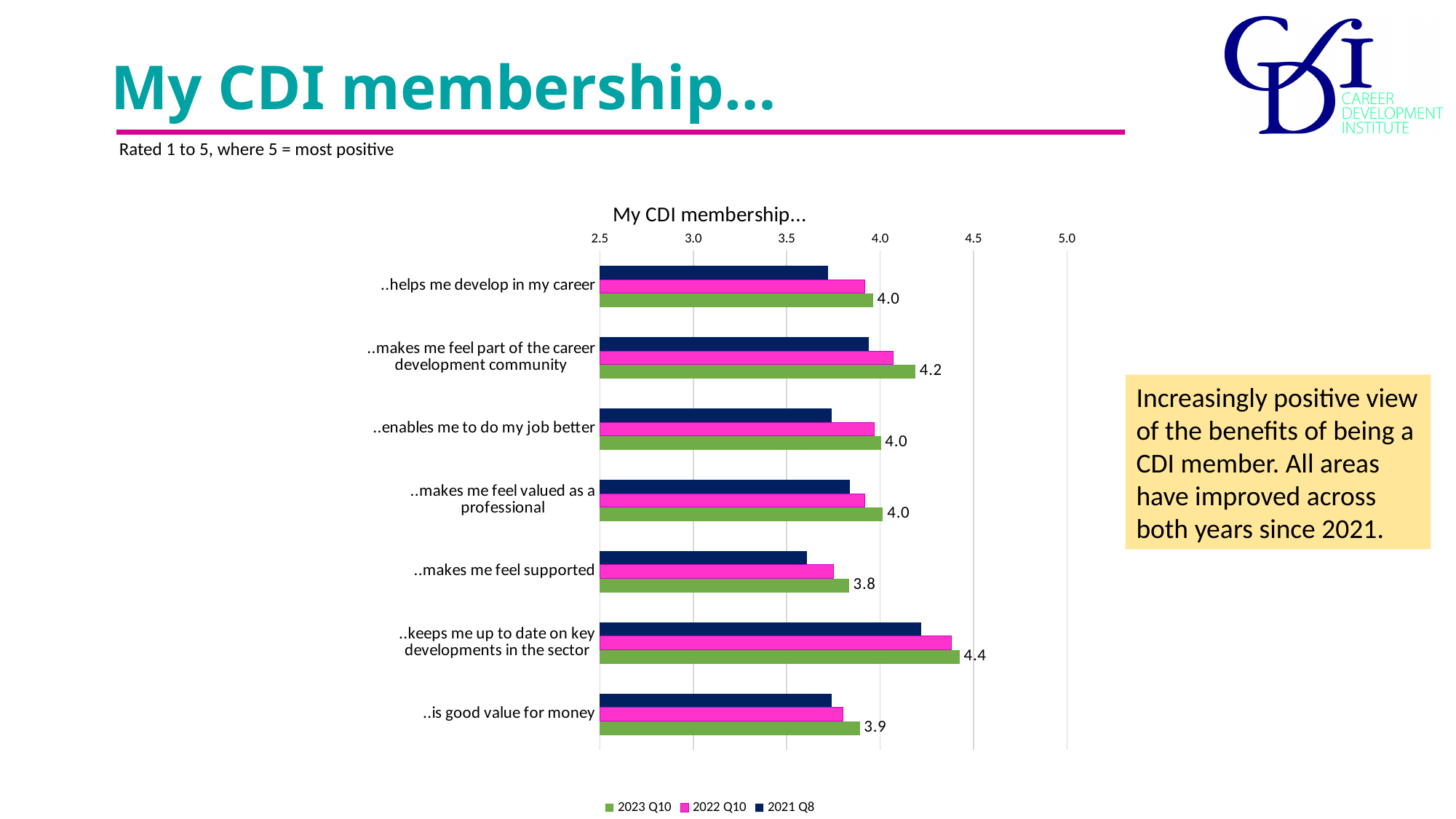
What is the 2023 Q10 value for "..is good value for money"? 3.9 For "..is good value for money", which series has the larger value: 2023 Q10 or 2021 Q8? 2023 Q10 Is the 2021 Q8 value for "..helps me develop in my career" greater or less than 4.0? less What is the 2023 Q10 value for "..makes me feel part of the career development community"? 4.2 What kind of chart is shown on the slide? Bar chart What is the 2023 Q10 value for "..keeps me up to date on key developments in the sector"? 4.4 Which category has the highest 2023 Q10 value? ..keeps me up to date on key developments in the sector How many series does the legend list? 3 What is the 2023 Q10 value for "..makes me feel supported"? 3.8 Which category has the lowest 2023 Q10 value? ..makes me feel supported How many categories are shown on the chart? 7 What is the difference between the 2023 Q10 values for "..keeps me up to date on key developments in the sector" and "..makes me feel supported"? 0.6